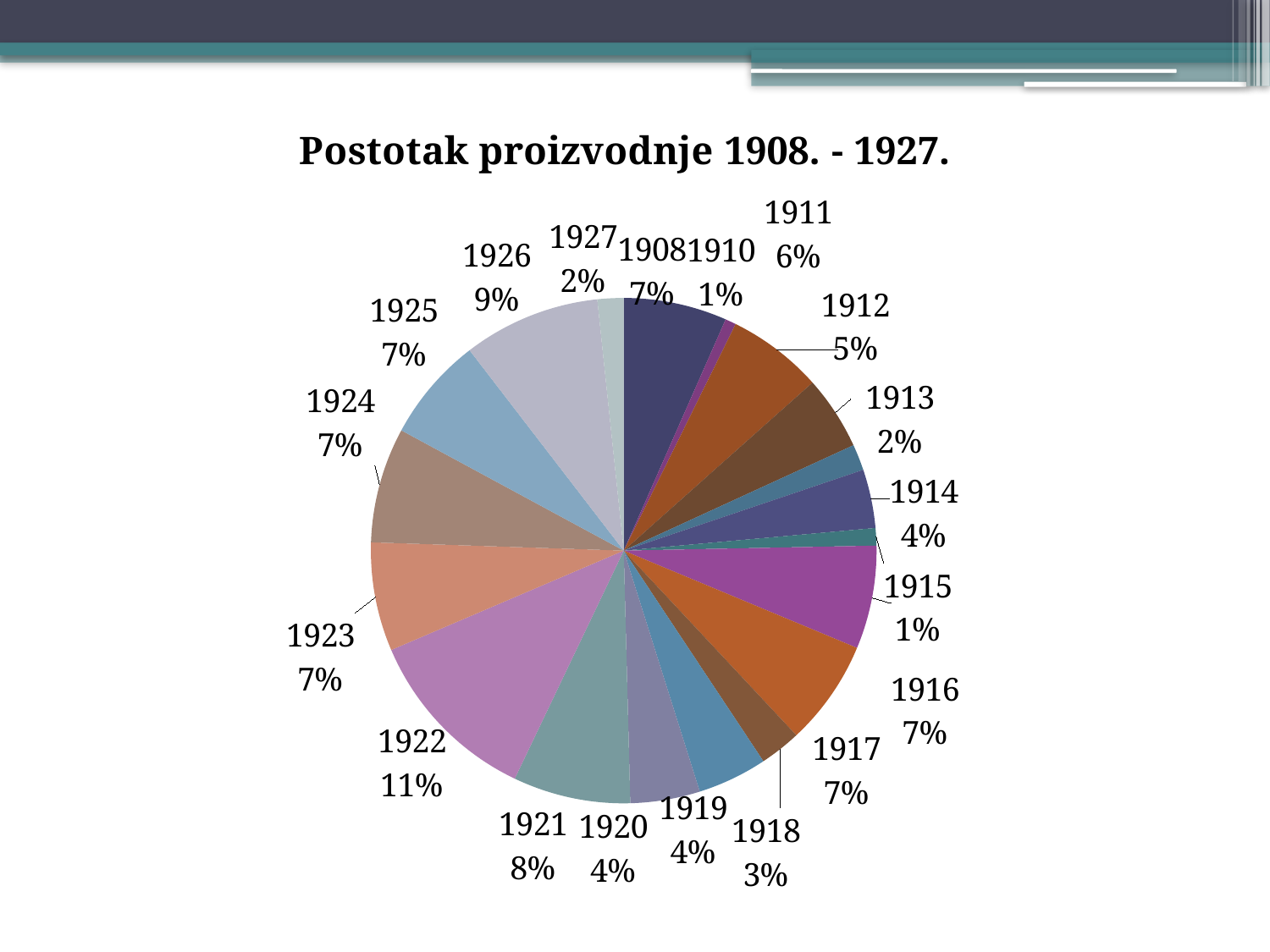
Which year has the largest share of the pie? 1922 What share of the pie does 1914 represent? 4% What is the difference between the shares for 1922 and 1926? 2% What percentage is shown for 1926? 9% What type of chart is shown on the slide? pie chart What is the title of the chart? Postotak proizvodnje 1908. - 1927. What is the difference between the shares for 1921 and 1918? 5% What percentage is shown for 1921? 8% Which has a larger share, 1911 or 1913? 1911 What percentage is shown for 1912? 5% What percentage is shown for 1918? 3% What percentage is shown for 1922? 11%